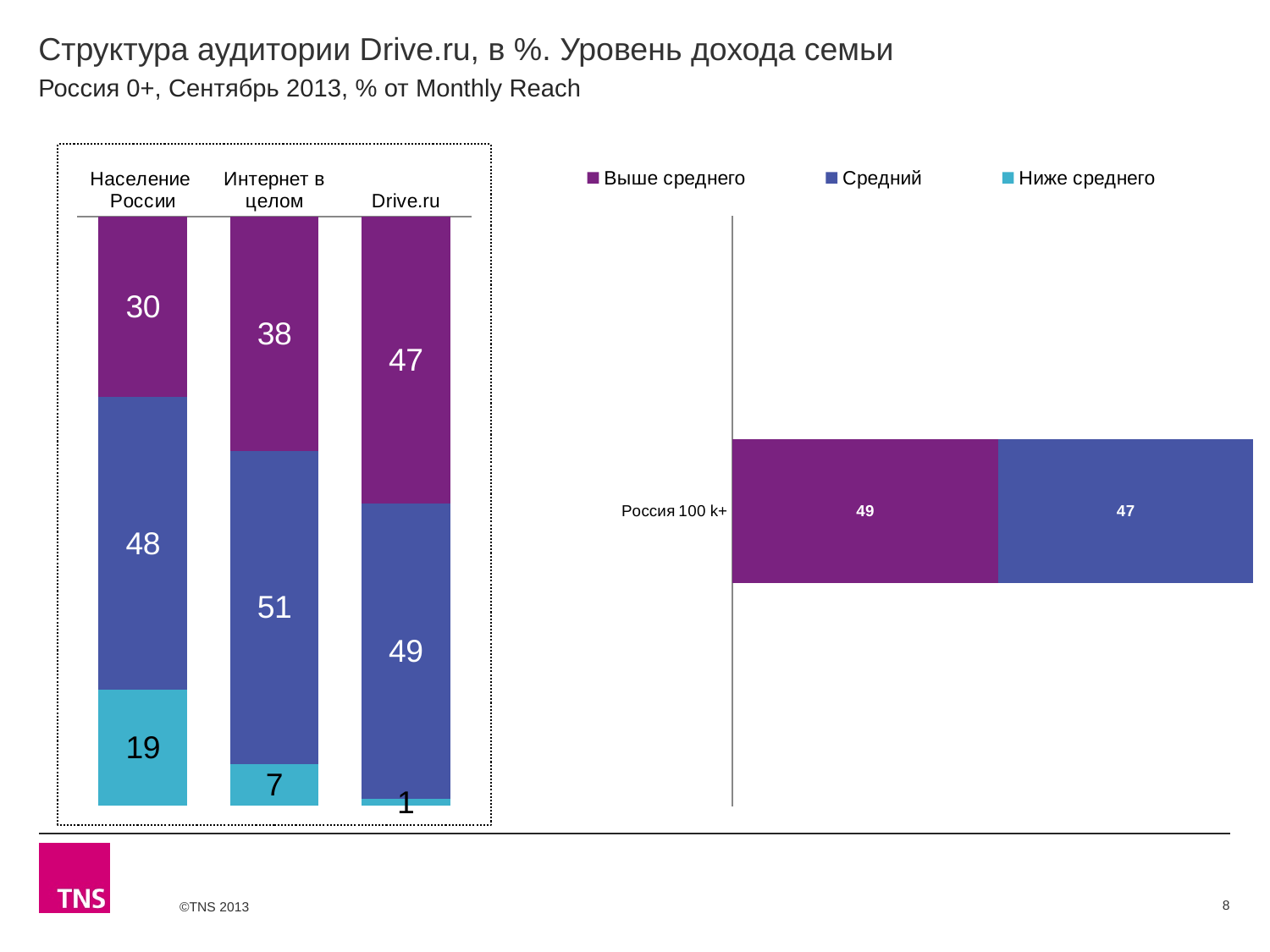
In the left chart, which category has the lowest 'Ниже среднего' value? Drive.ru In the left chart, which is larger: the 'Средний' value for Интернет в целом or for Население России? Интернет в целом In the left chart, what is the value of the 'Средний' segment for Интернет в целом? 51 In the left chart, what is the value of the 'Выше среднего' segment for Drive.ru? 47 In the left chart, what is the value of the 'Ниже среднего' segment for Население России? 19 In the right chart, what is the total of the 'Выше среднего' and 'Средний' segments for Россия 100 k+? 96 In the right chart, what is the 'Выше среднего' value for Россия 100 k+? 49 In the left chart, what is the difference between the 'Выше среднего' values for Drive.ru and Население России? 17 How many categories are shown in the left chart? 3 What kind of chart is the left chart? Stacked bar chart In the left chart, which category has the highest 'Выше среднего' value? Drive.ru How many series does the legend list? 3